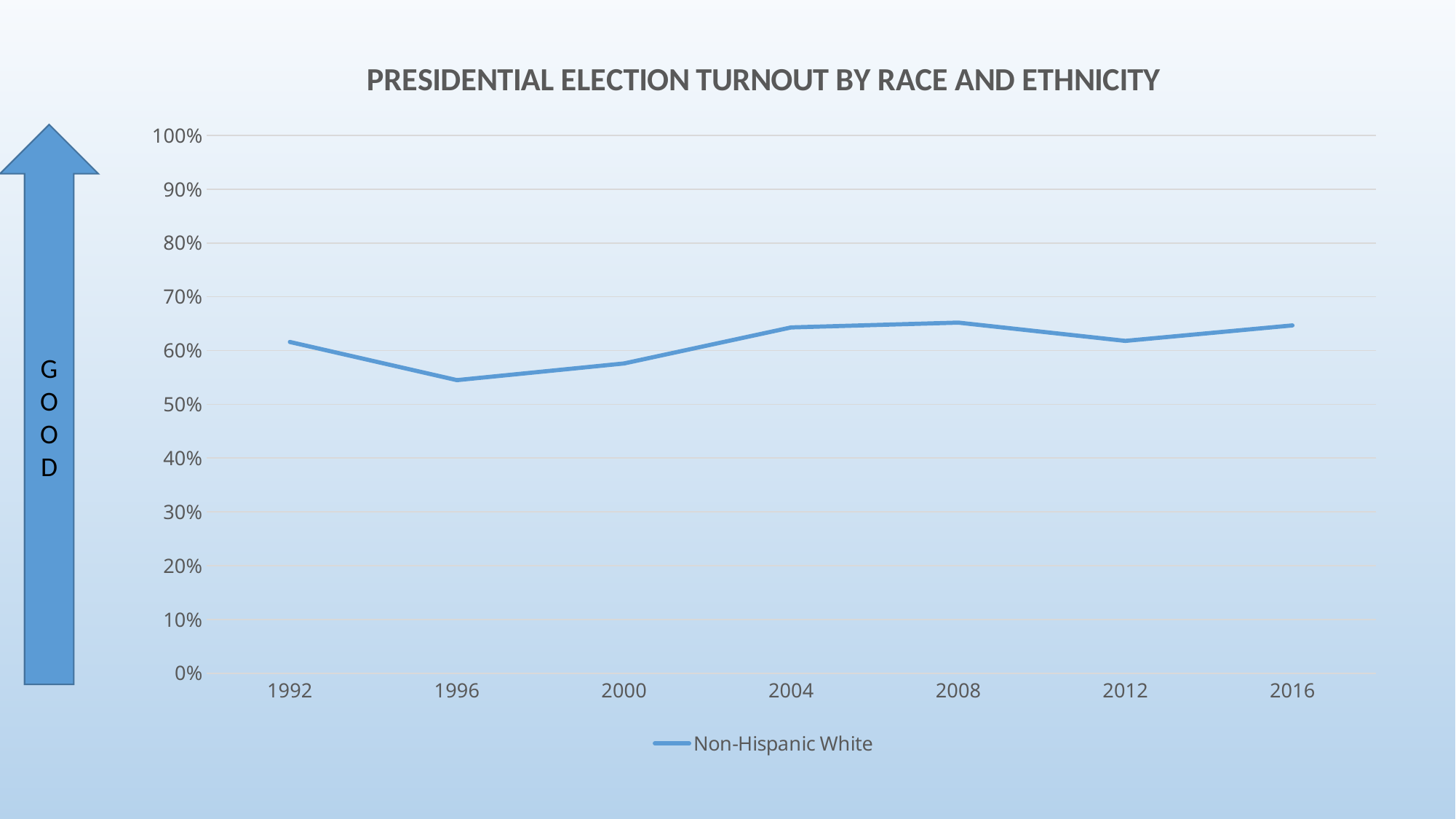
In which year is the Non-Hispanic White turnout lowest? 1996 Which year has the higher turnout, 2000 or 2004? 2004 Which year has the higher turnout, 1996 or 2008? 2008 What kind of chart is shown on the slide? line chart What is the title of the chart? PRESIDENTIAL ELECTION TURNOUT BY RACE AND ETHNICITY Does the turnout rise or fall from 1996 to 2008? rise Is the value for 1996 greater or less than 60%? less How many election years are plotted on the x axis? 7 Is the value for 2008 greater or less than 60%? greater What series name appears in the legend? Non-Hispanic White How many series does the legend list? 1 Is the value for 2000 greater or less than 60%? less